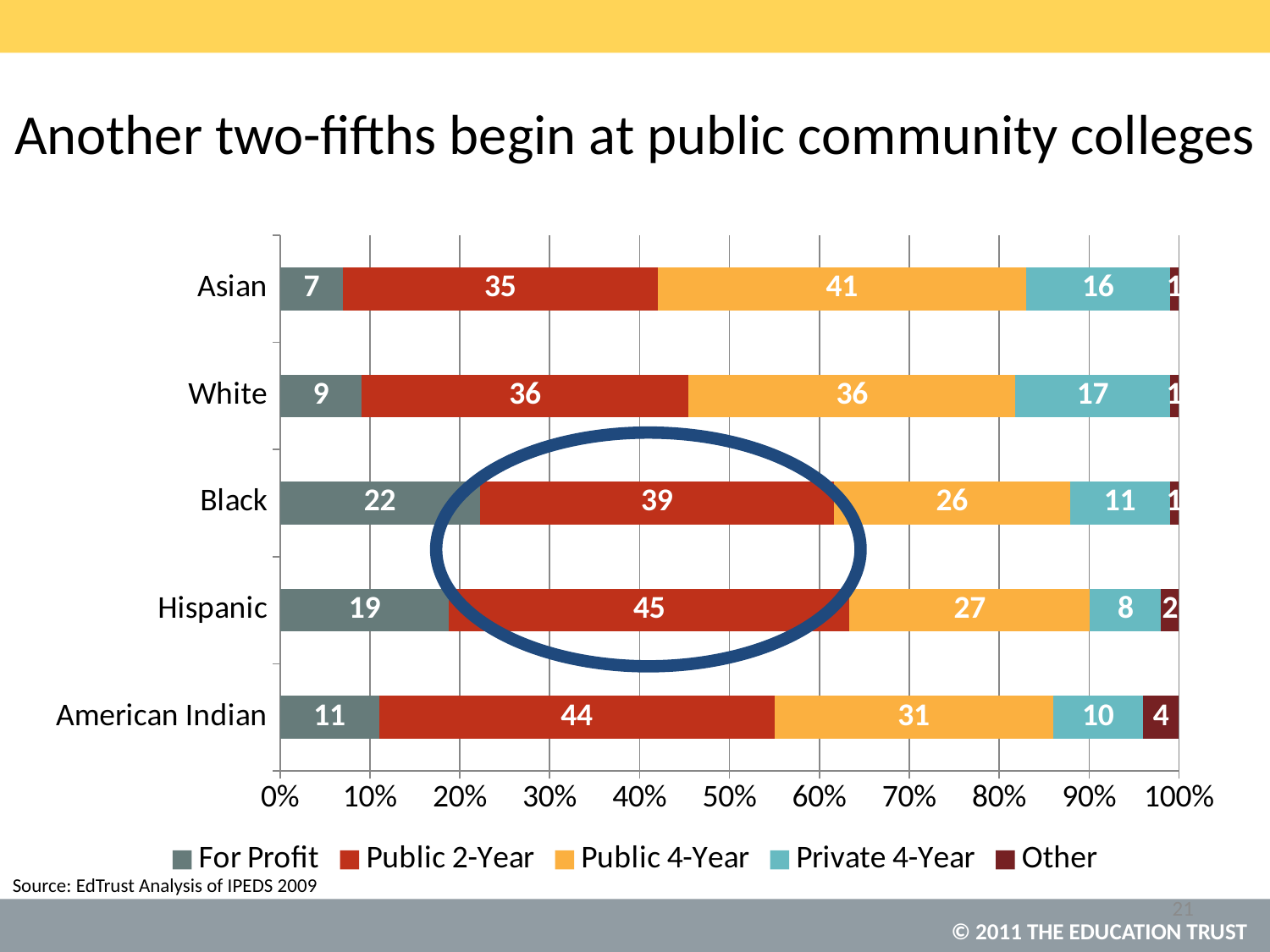
Which category has the highest Other value? American Indian What is the Public 2-Year value for Hispanic? 45 Which category has the highest Public 2-Year value? Hispanic What is the For Profit value for Black? 22 Which category has the lowest For Profit value? Asian What is the total of the stacked bar for American Indian? 100 What is the difference between the Public 4-Year values for Asian and Black? 15 How many categories are shown on the chart? 5 What kind of chart is shown on the slide? Stacked bar chart How many series does the legend list? 5 Which is larger, the Private 4-Year value for White or for Hispanic? White What is the Public 4-Year value for Asian? 41